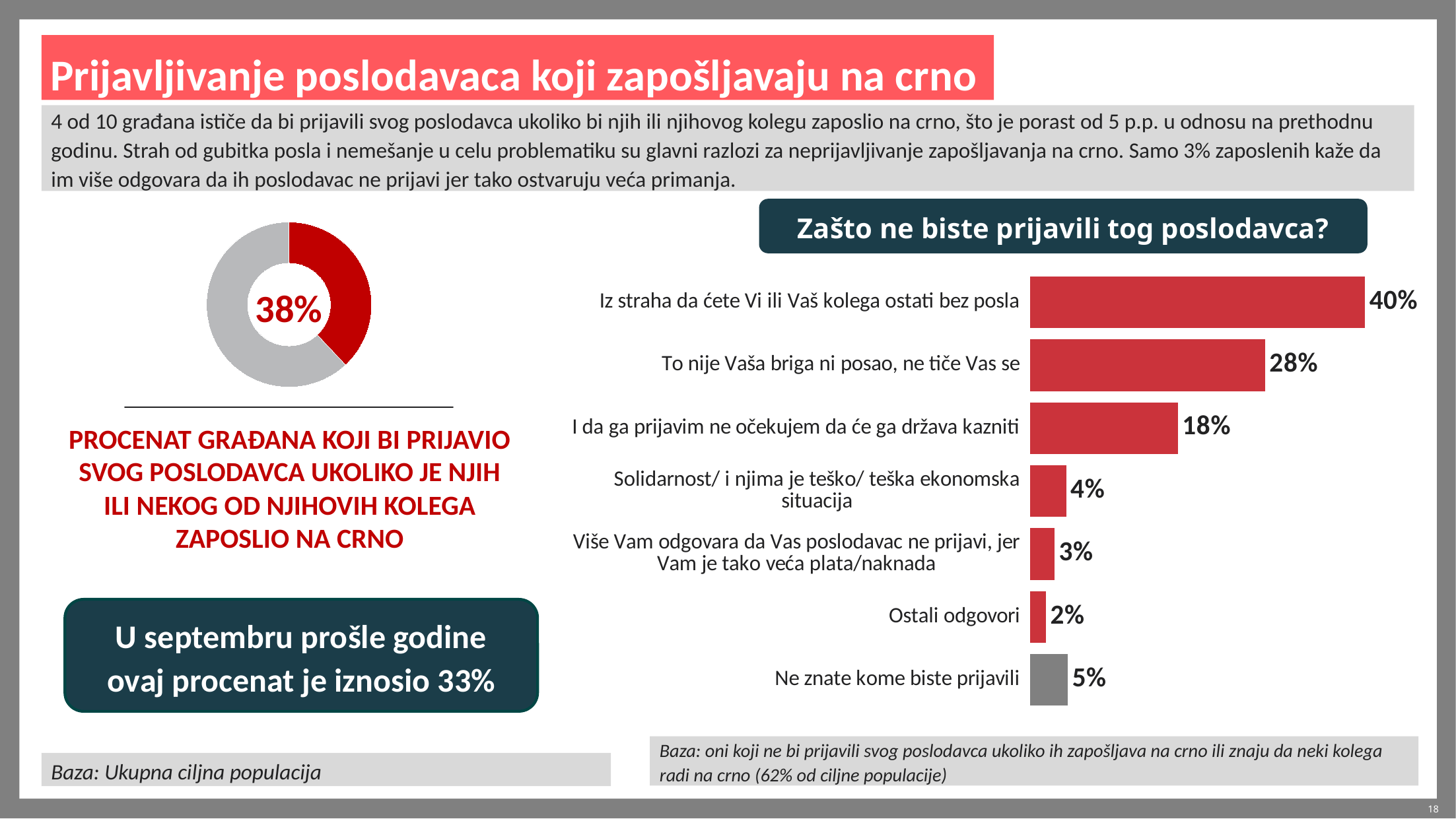
In the bar chart 'Zašto ne biste prijavili tog poslodavca?', what is the difference between 'Iz straha da ćete Vi ili Vaš kolega ostati bez posla' and 'To nije Vaša briga ni posao, ne tiče Vas se'? 12 percentage points What kind of chart is 'Zašto ne biste prijavili tog poslodavca?'? Bar chart In the bar chart 'Zašto ne biste prijavili tog poslodavca?', which bar is coloured grey instead of red? Ne znate kome biste prijavili In the bar chart 'Zašto ne biste prijavili tog poslodavca?', which is larger: 'Solidarnost/ i njima je teško/ teška ekonomska situacija' or 'Ne znate kome biste prijavili'? Ne znate kome biste prijavili In the bar chart 'Zašto ne biste prijavili tog poslodavca?', which category has the highest value? Iz straha da ćete Vi ili Vaš kolega ostati bez posla In the bar chart 'Zašto ne biste prijavili tog poslodavca?', what is the value for 'To nije Vaša briga ni posao, ne tiče Vas se'? 28% How many categories does the bar chart 'Zašto ne biste prijavili tog poslodavca?' show? 7 In the bar chart 'Zašto ne biste prijavili tog poslodavca?', what is the value for 'Iz straha da ćete Vi ili Vaš kolega ostati bez posla'? 40% In the bar chart 'Zašto ne biste prijavili tog poslodavca?', which category has the lowest value? Ostali odgovori In the bar chart 'Zašto ne biste prijavili tog poslodavca?', what is the value for 'Ne znate kome biste prijavili'? 5% What kind of chart is shown on the left side of the slide? Donut chart What percentage is shown in the centre of the donut chart on the left? 38%